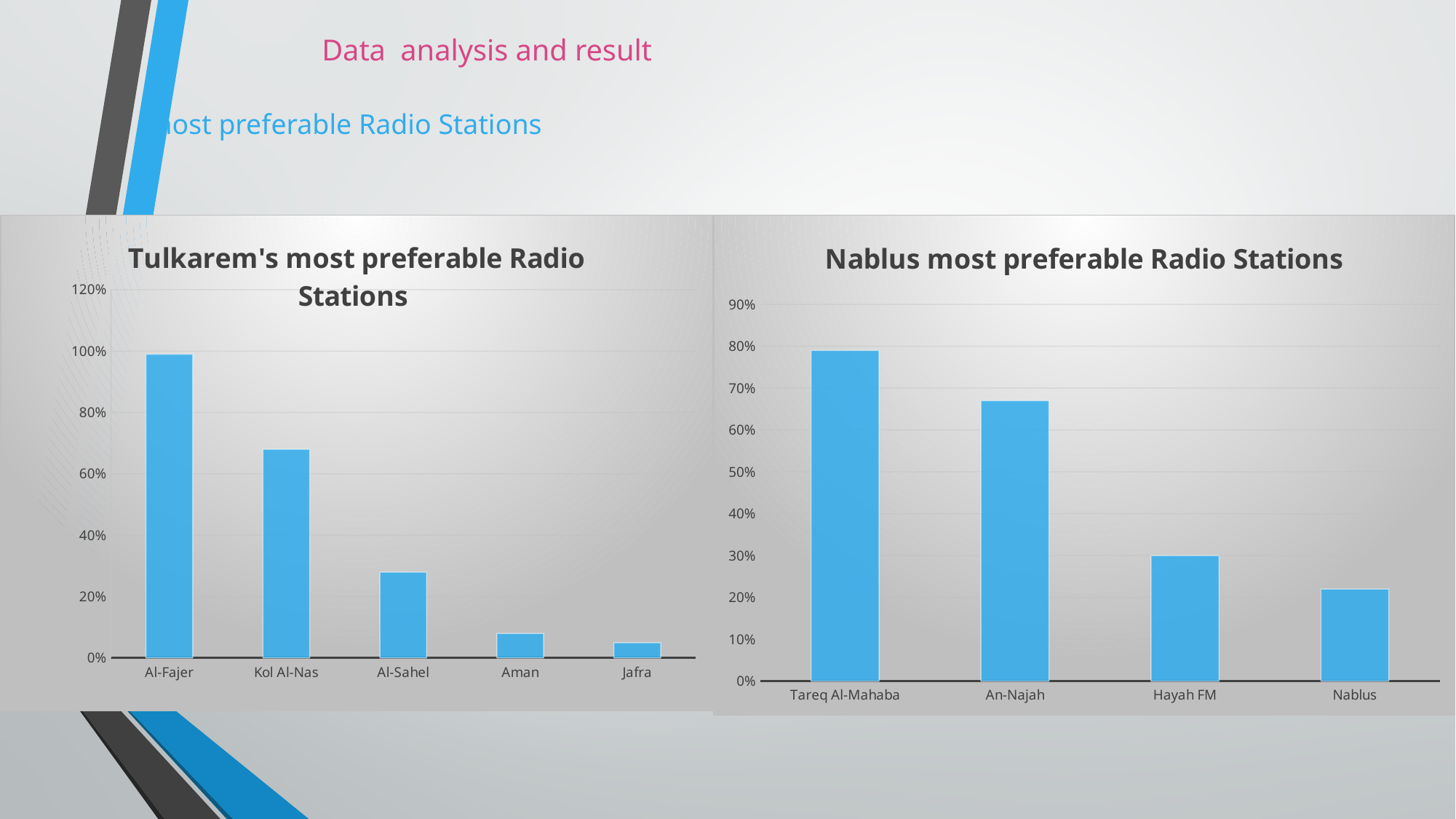
On the Nablus most preferable Radio Stations chart, which station has the lowest value? Nablus On the Nablus most preferable Radio Stations chart, which station has the highest value? Tareq Al-Mahaba On the Tulkarem's most preferable Radio Stations chart, is the value for Kol Al-Nas greater or less than 60%? greater What kind of chart is the Nablus most preferable Radio Stations chart? bar chart On the Tulkarem's most preferable Radio Stations chart, is the value for Al-Sahel greater or less than 40%? less On the Nablus most preferable Radio Stations chart, which is larger, the value for An-Najah or the value for Hayah FM? An-Najah On the Tulkarem's most preferable Radio Stations chart, how many stations are shown? 5 On the Tulkarem's most preferable Radio Stations chart, which station has the lowest value? Jafra On the Tulkarem's most preferable Radio Stations chart, which station has the highest value? Al-Fajer On the Tulkarem's most preferable Radio Stations chart, is the value for Al-Fajer greater or less than 80%? greater